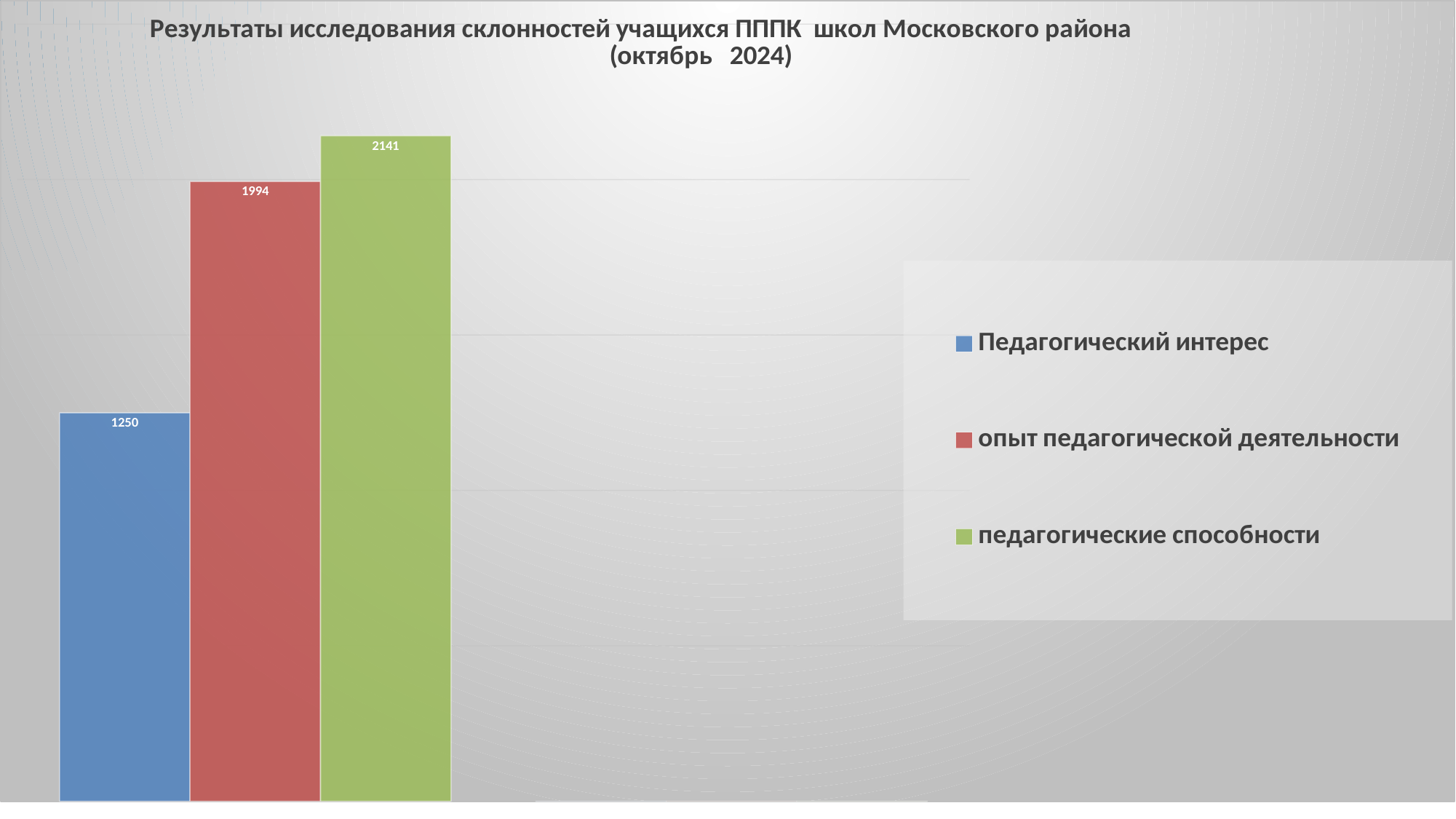
Which series has the lowest value? Педагогический интерес What is the difference between the values for педагогические способности and Педагогический интерес? 891 Which month and year are given in the chart title? октябрь 2024 What is the difference between the values for педагогические способности and опыт педагогической деятельности? 147 How many series does the legend list? 3 What is the value for педагогические способности? 2141 What is the value for Педагогический интерес? 1250 What is the value for опыт педагогической деятельности? 1994 What kind of chart is shown on the slide? bar chart Which is larger, the value for опыт педагогической деятельности or the value for Педагогический интерес? опыт педагогической деятельности What colour is the bar for опыт педагогической деятельности? red Which series has the highest value? педагогические способности